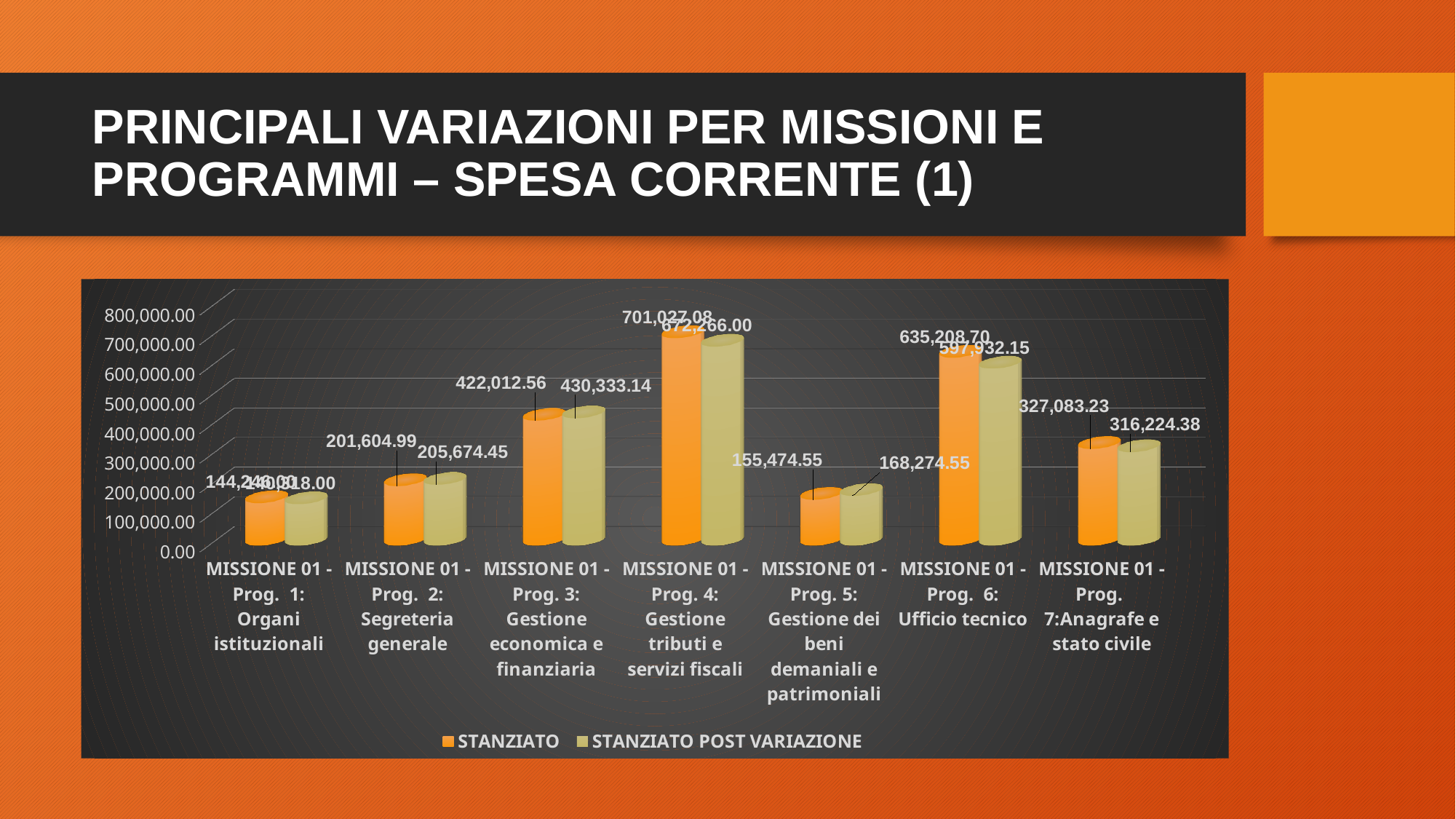
How many series does the legend list? 2 What is the STANZIATO POST VARIAZIONE value for MISSIONE 01 - Prog. 5: Gestione dei beni demaniali e patrimoniali? 168,274.55 Which programme has the lowest STANZIATO POST VARIAZIONE value? MISSIONE 01 - Prog. 1: Organi istituzionali For MISSIONE 01 - Prog. 3: Gestione economica e finanziaria, which is larger: STANZIATO or STANZIATO POST VARIAZIONE? STANZIATO POST VARIAZIONE What is the difference between STANZIATO and STANZIATO POST VARIAZIONE for MISSIONE 01 - Prog. 6: Ufficio tecnico? 37,276.55 What is the STANZIATO value for MISSIONE 01 - Prog. 4: Gestione tributi e servizi fiscali? 701,027.08 How many programmes are shown on the x axis of the chart? 7 What is the STANZIATO value for MISSIONE 01 - Prog. 2: Segreteria generale? 201,604.99 What is the difference between STANZIATO POST VARIAZIONE and STANZIATO for MISSIONE 01 - Prog. 5: Gestione dei beni demaniali e patrimoniali? 12,800.00 Is the STANZIATO value for MISSIONE 01 - Prog. 7: Anagrafe e stato civile greater or less than 300,000.00? greater What is the STANZIATO POST VARIAZIONE value for MISSIONE 01 - Prog. 6: Ufficio tecnico? 597,932.15 Which programme has the highest STANZIATO value? MISSIONE 01 - Prog. 4: Gestione tributi e servizi fiscali